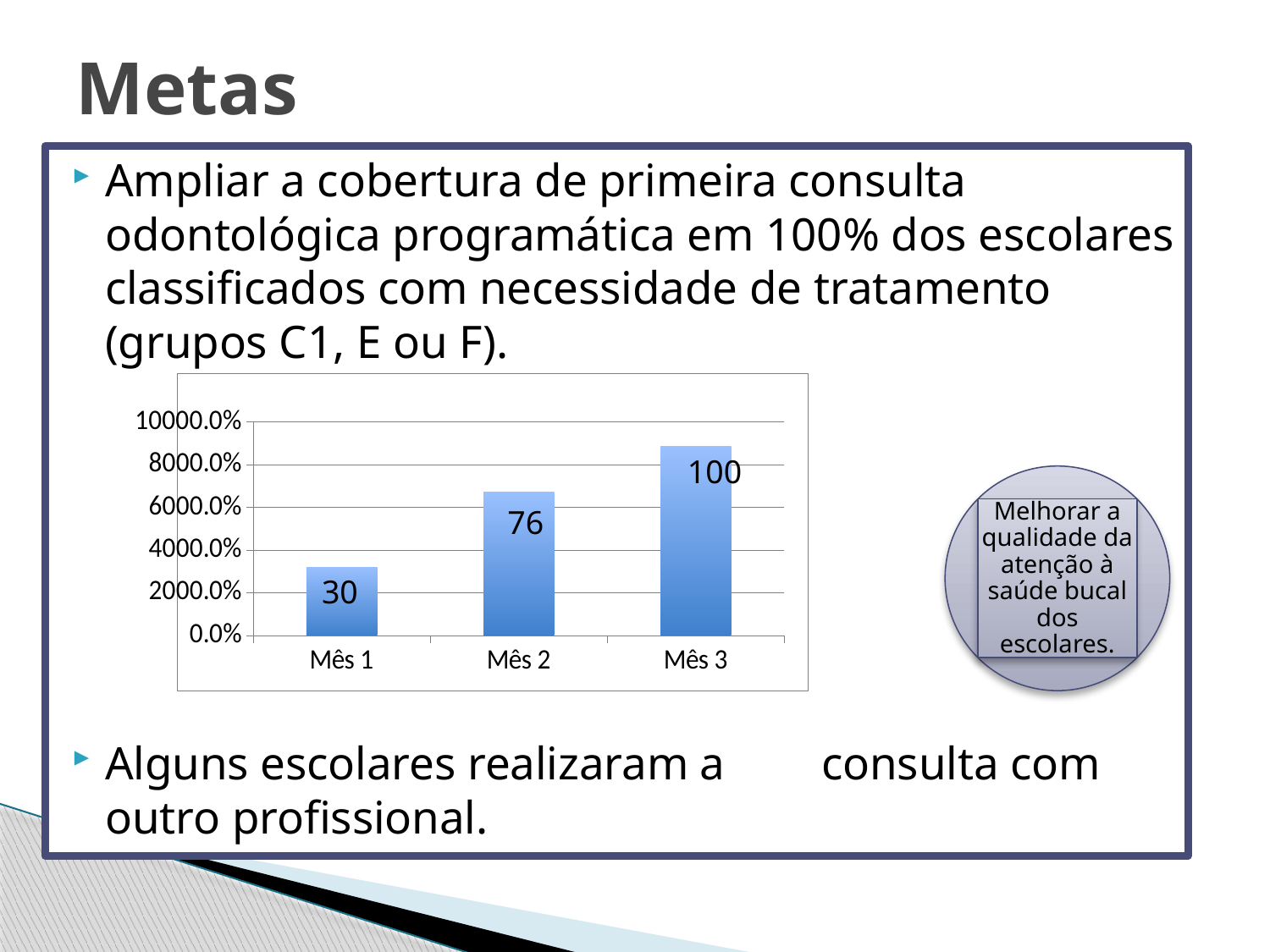
What kind of chart is shown on the slide? Bar chart How many categories are shown on the x axis of the chart? 3 Which month has the lowest bar? Mês 1 Which month has the highest bar? Mês 3 What is the difference between the data labels for Mês 3 and Mês 1? 70 What is the data label shown on the bar for Mês 1? 30 What is the difference between the data labels for Mês 2 and Mês 1? 46 Which is larger, the value for Mês 2 or the value for Mês 1? Mês 2 What is the data label shown on the bar for Mês 3? 100 What is the highest tick label shown on the y axis of the chart? 10000.0% What is the data label shown on the bar for Mês 2? 76 Do the bar values rise or fall from Mês 1 to Mês 3? Rise